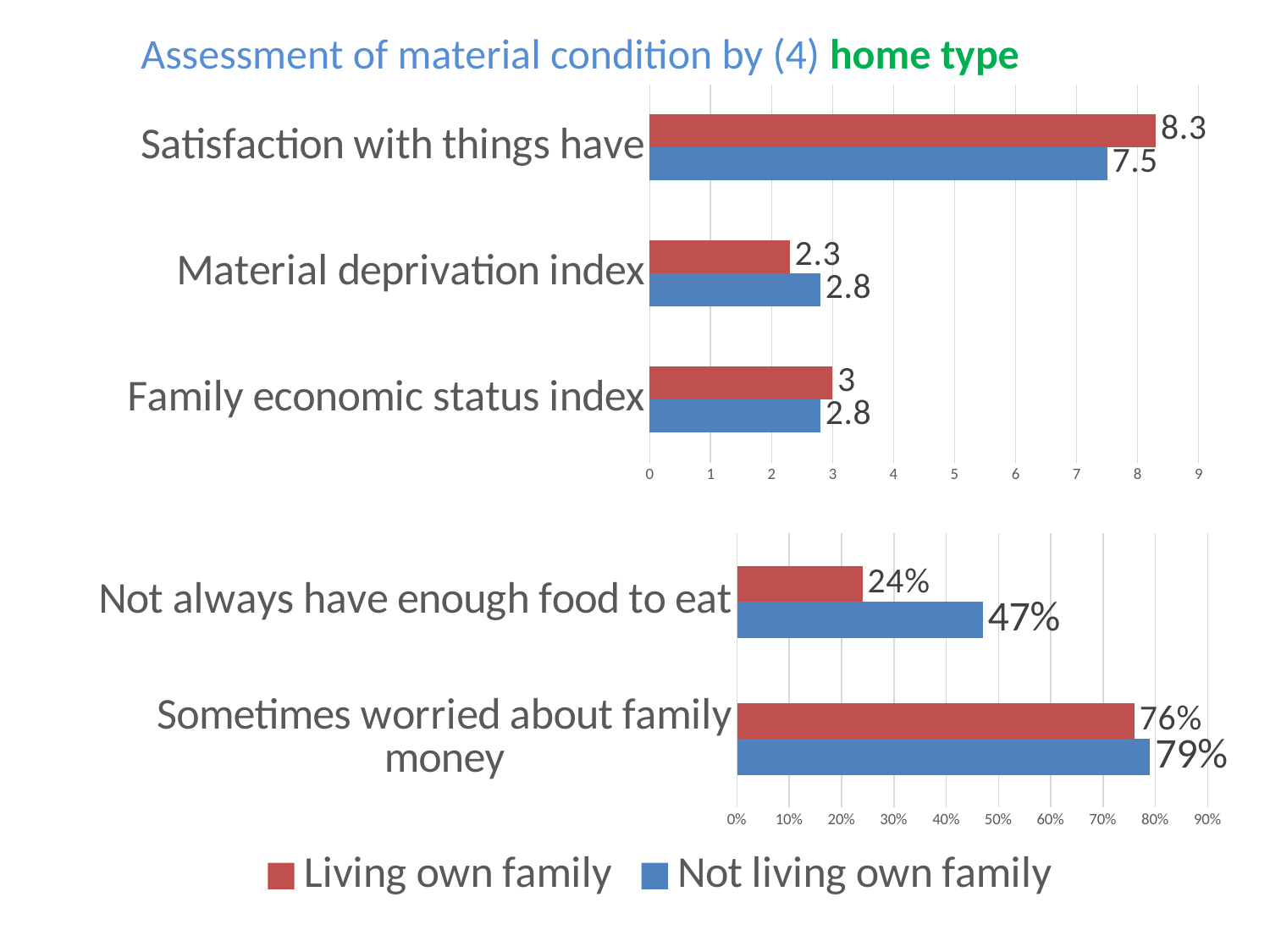
In the top chart, which category has the lowest value for Living own family? Material deprivation index How many categories are shown in the top chart? 3 In the bottom chart, what is the value for 'Sometimes worried about family money' for Living own family? 76% In the top chart, what is the value for 'Satisfaction with things have' for Living own family? 8.3 In the top chart, which group has the higher value for 'Material deprivation index'? Not living own family In the bottom chart, which category has the highest value for Not living own family? Sometimes worried about family money How many series does the legend list? 2 In the bottom chart, what is the value for 'Not always have enough food to eat' for Not living own family? 47% In the bottom chart, what is the difference between the Not living own family and Living own family values for 'Not always have enough food to eat'? 23% In the top chart, what is the value for 'Material deprivation index' for Not living own family? 2.8 In the top chart, what is the difference between the Living own family and Not living own family values for 'Satisfaction with things have'? 0.8 What type of chart is the bottom chart? Bar chart